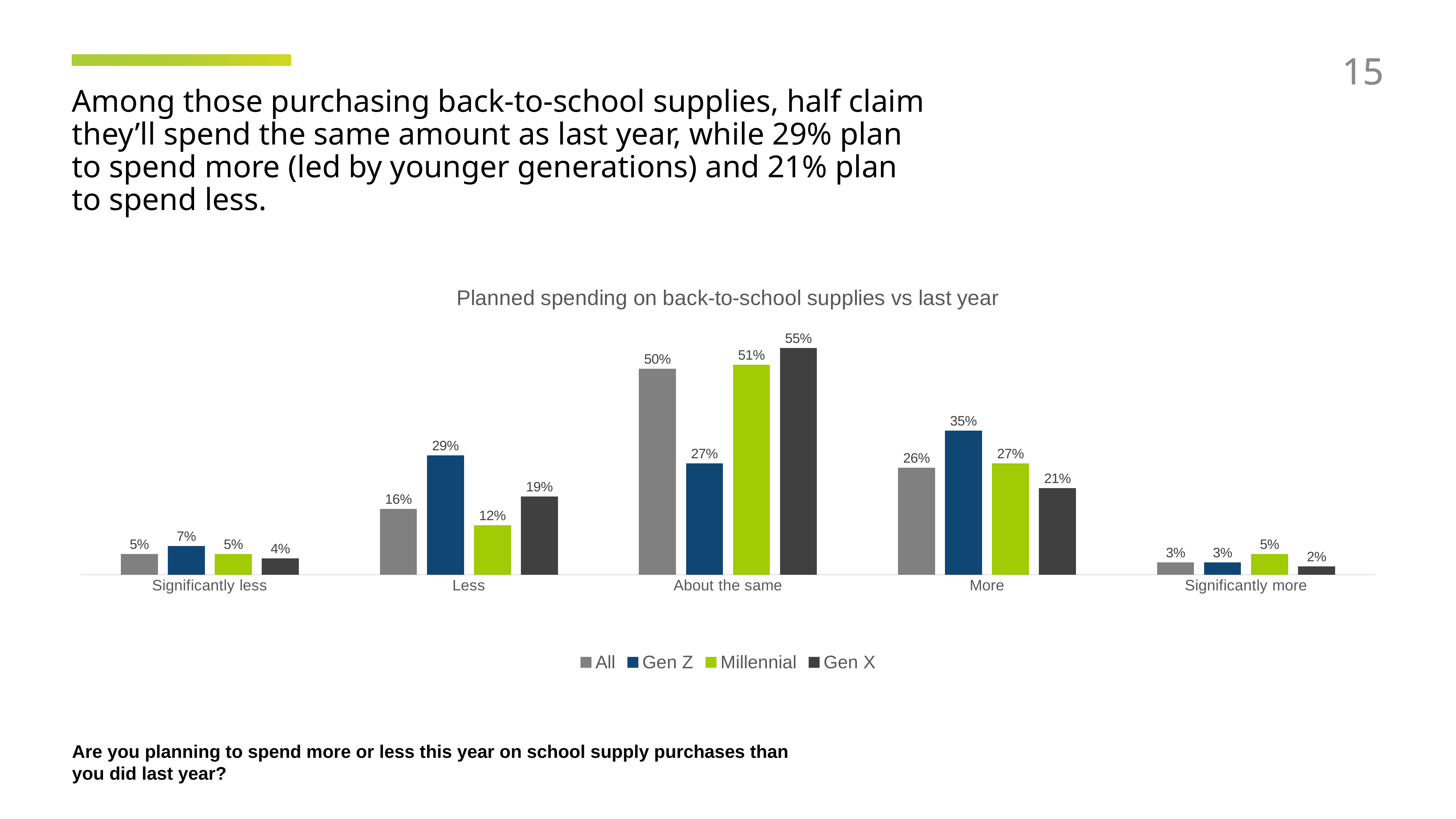
What kind of chart is shown on the slide? Bar chart Which series has the highest value in the "More" category? Gen Z What is the value for Gen X in the "About the same" category? 55% Which is larger in the "About the same" category: the value for All or the value for Millennial? Millennial What is the difference between the Gen Z and Millennial values in the "Less" category? 17% What is the value for Gen Z in the "Less" category? 29% How many series does the legend list? 4 What is the title of the chart? Planned spending on back-to-school supplies vs last year How many categories are shown on the x axis? 5 What is the value for All in the "Significantly more" category? 3% Which series has the lowest value in the "About the same" category? Gen Z What is the value for Millennial in the "More" category? 27%